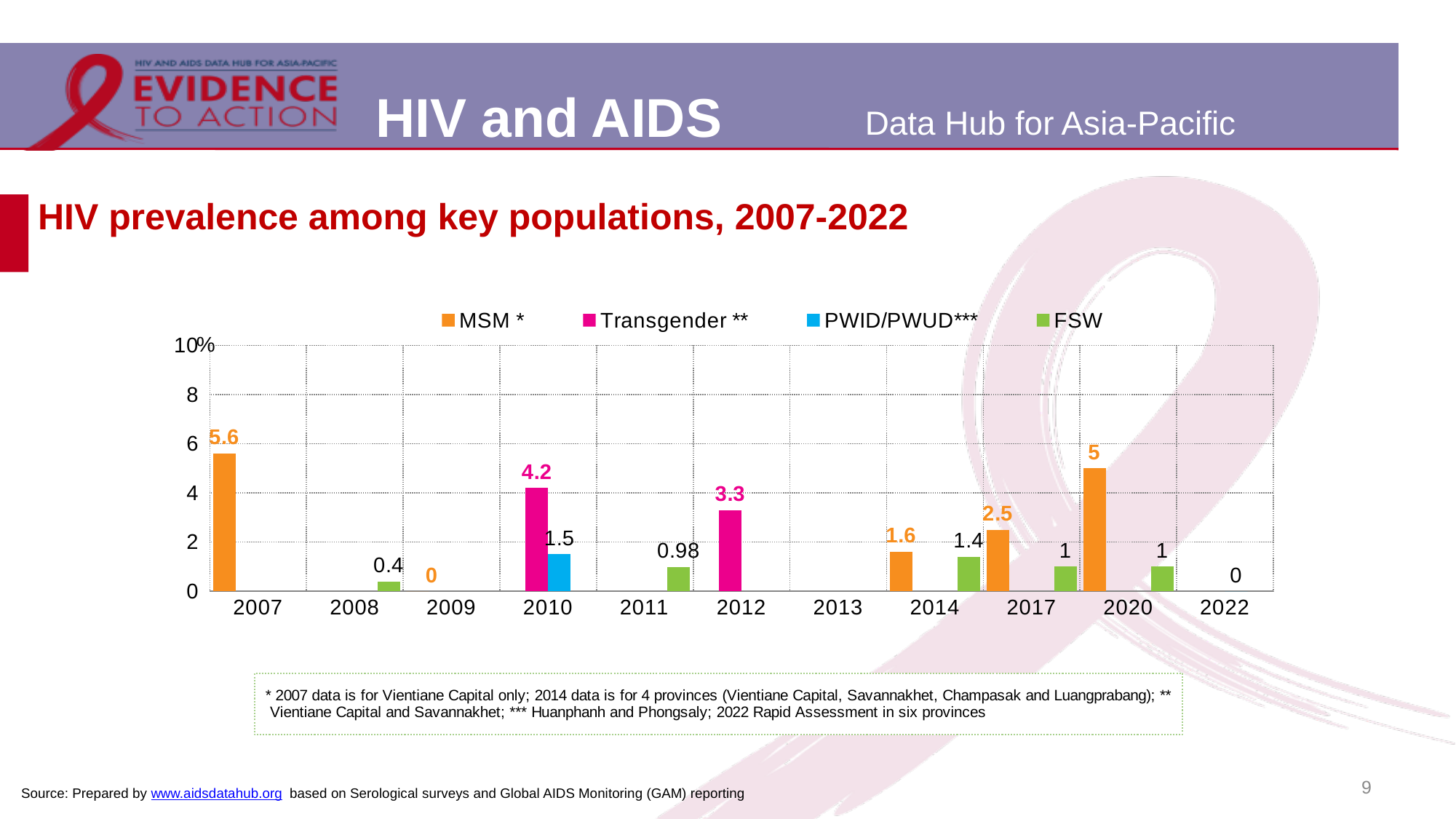
What kind of chart is shown on the slide? Bar chart How many years are shown on the x axis? 11 What is the value for Transgender in 2010? 4.2 What is the value for PWID/PWUD in 2010? 1.5 How many series does the legend list? 4 What is the HIV prevalence value for MSM in 2007? 5.6 In 2014, how much higher is the MSM value than the FSW value? 0.2 What is the value for FSW in 2011? 0.98 What is the difference between the MSM value in 2007 and the MSM value in 2020? 0.6 Which year has the larger Transgender value, 2010 or 2012? 2010 What is the value for MSM in 2017? 2.5 In which year is the MSM value highest? 2007